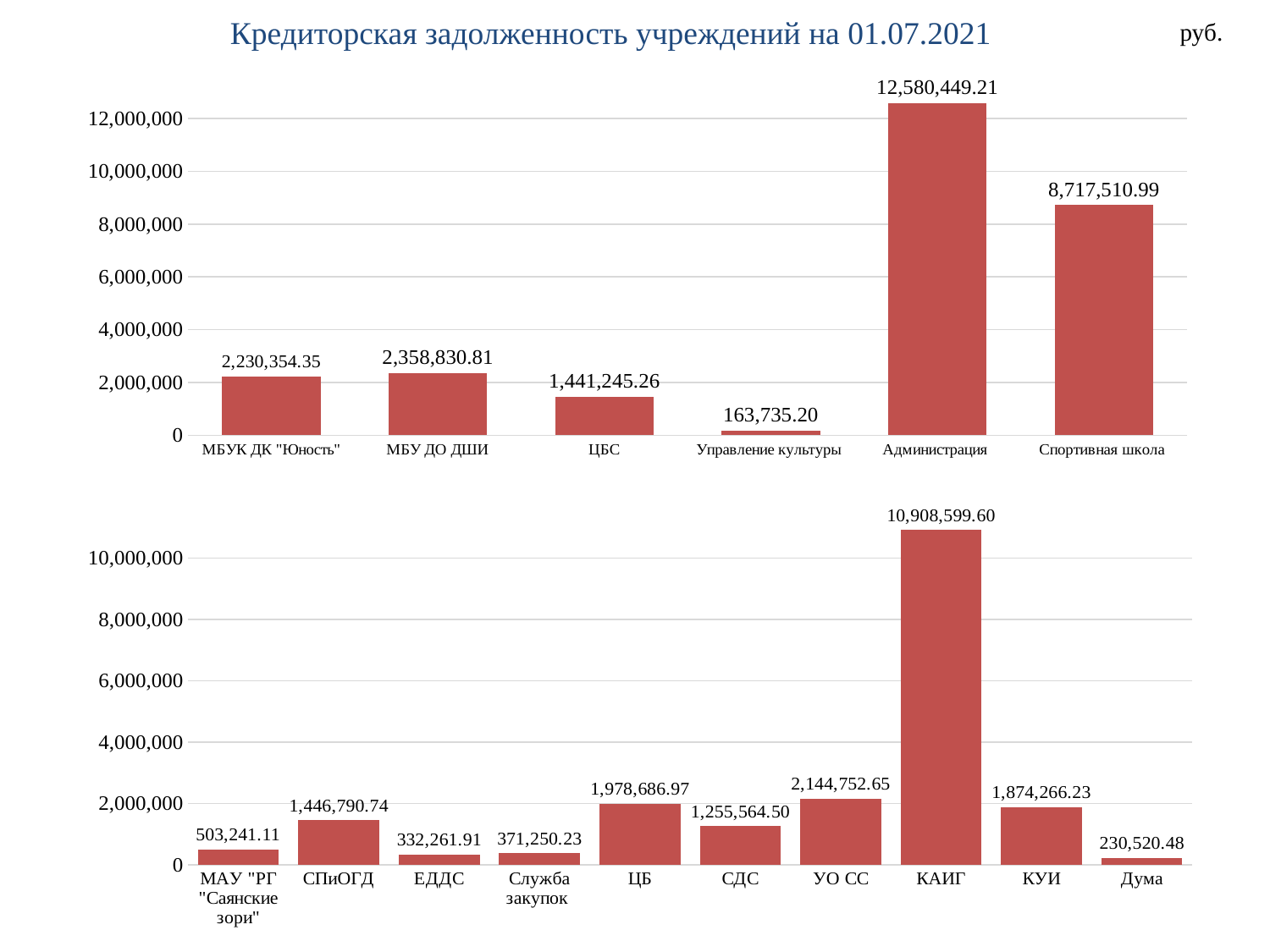
In the top chart, how many categories are shown? 6 In the bottom chart, which category has the lowest value? Дума In the bottom chart, what is the value for Служба закупок? 371,250.23 In the bottom chart, what is the difference between УО СС and КУИ? 270,486.42 In the bottom chart, which is larger: УО СС or ЦБ? УО СС In the top chart, what is the value for Администрация? 12,580,449.21 In the top chart, which category has the lowest value? Управление культуры What type of chart is the bottom chart? bar chart In the bottom chart, what is the value for КАИГ? 10,908,599.60 In the top chart, what is the value for Управление культуры? 163,735.20 In the top chart, what is the difference between Администрация and Спортивная школа? 3,862,938.22 In the top chart, which category has the highest value? Администрация